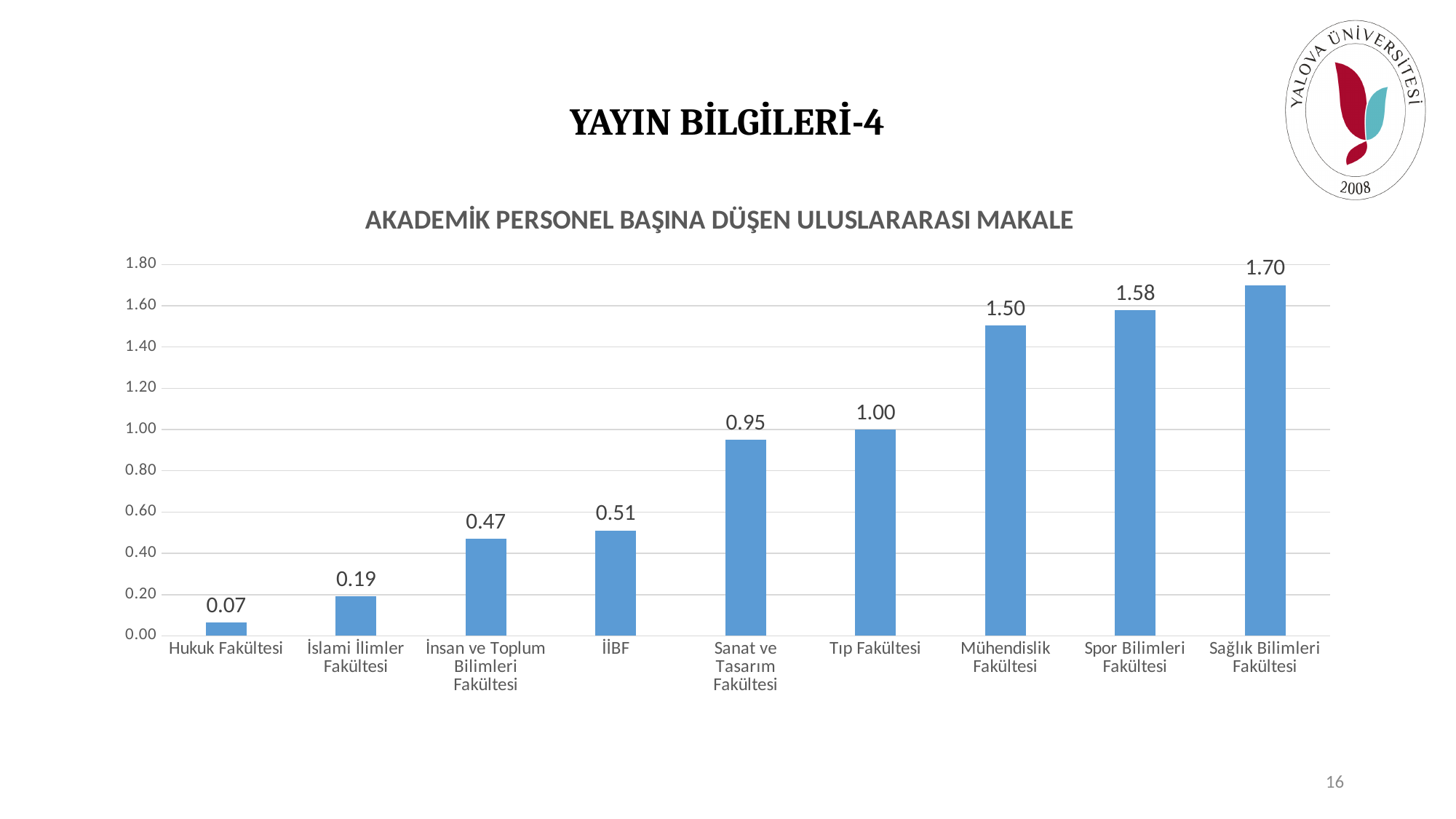
What is the difference between the values for Spor Bilimleri Fakültesi and Mühendislik Fakültesi? 0.08 How many faculties are shown on the chart? 9 Which faculty has the highest value? Sağlık Bilimleri Fakültesi What is the value for İslami İlimler Fakültesi? 0.19 What is the value for Tıp Fakültesi? 1.00 What is the title of the chart? AKADEMİK PERSONEL BAŞINA DÜŞEN ULUSLARARASI MAKALE Which faculty has the lowest value? Hukuk Fakültesi Which is larger, the value for Sağlık Bilimleri Fakültesi or Spor Bilimleri Fakültesi? Sağlık Bilimleri Fakültesi What is the value for Sanat ve Tasarım Fakültesi? 0.95 What kind of chart is shown on the slide? Bar chart What is the difference between the values for İİBF and İnsan ve Toplum Bilimleri Fakültesi? 0.04 Is the value for Mühendislik Fakültesi greater or less than 1.40? greater